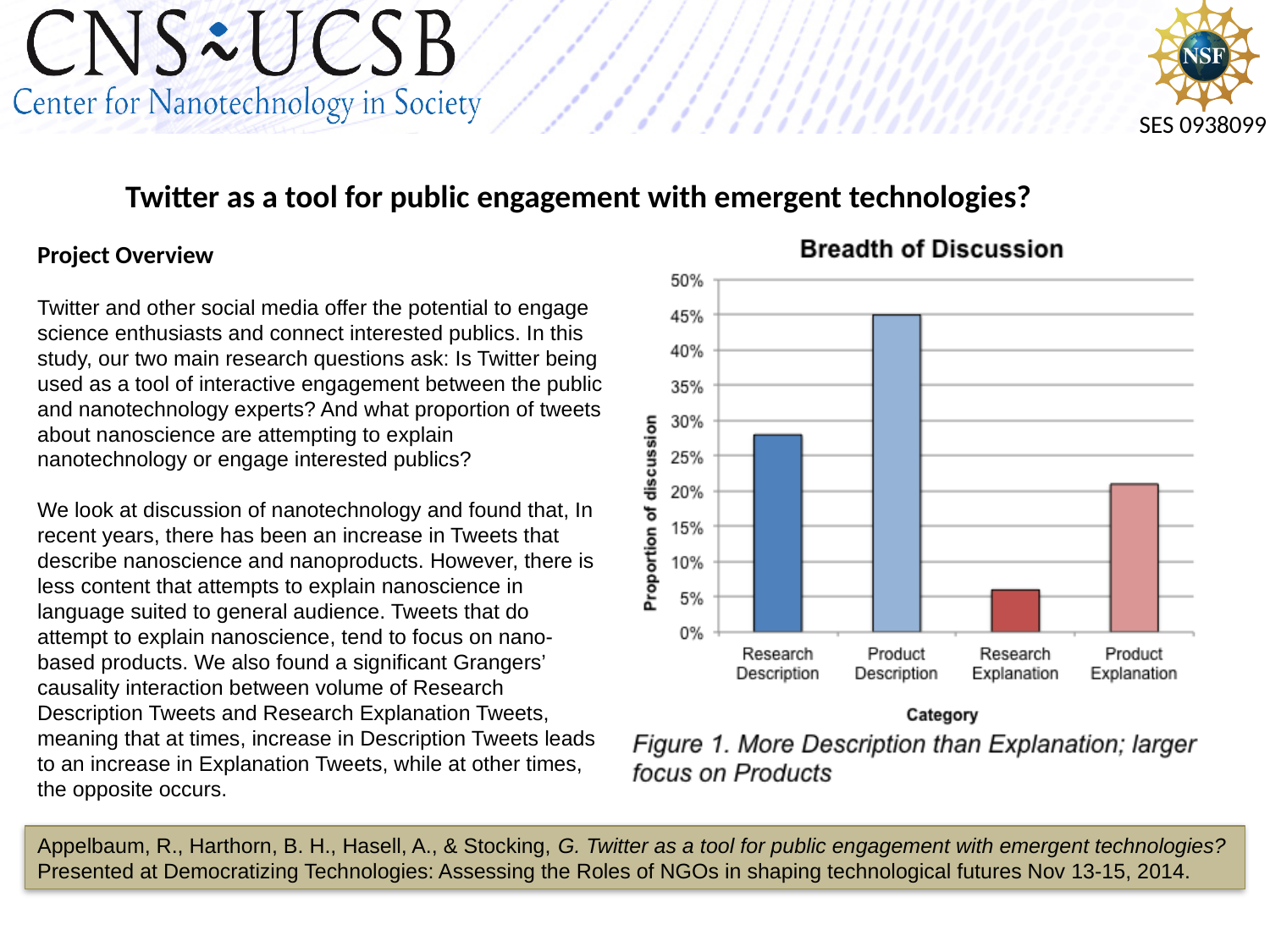
Is the value for Research Explanation greater or less than 10%? less Is the value for Product Explanation greater or less than 25%? less What kind of chart is shown on the slide? bar chart Is the value for Research Description greater or less than 25%? greater Which is larger, the value for Research Description or the value for Product Explanation? Research Description What is the title of the chart? Breadth of Discussion Which category has the lowest proportion of discussion? Research Explanation Which is larger, the value for Product Description or the value for Research Explanation? Product Description What is the proportion of discussion for Product Description? 45% What is the label of the vertical axis of the chart? Proportion of discussion How many categories are plotted in the chart? 4 Which category has the highest proportion of discussion? Product Description